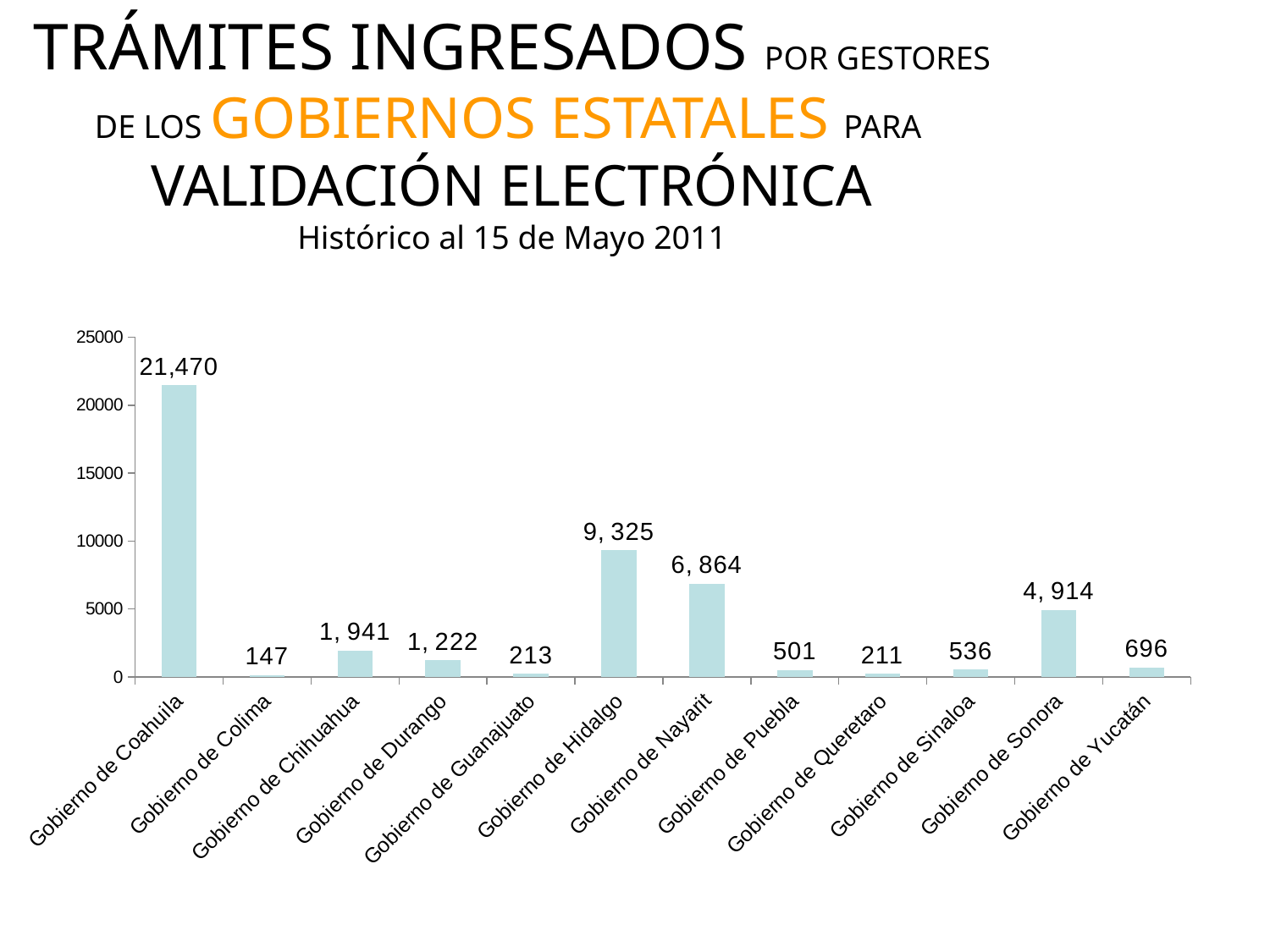
Is the value for Gobierno de Coahuila greater or less than 20000? greater What is the value for Gobierno de Coahuila? 21,470 Up to what date does the slide say the data is historical? 15 de Mayo 2011 Which category has the lowest value? Gobierno de Colima What is the value for Gobierno de Hidalgo? 9, 325 How many categories are shown on the x axis? 12 Which category has the highest value? Gobierno de Coahuila What is the difference between the values for Gobierno de Coahuila and Gobierno de Hidalgo? 12,145 What kind of chart is shown on the slide? bar chart What is the value for Gobierno de Sonora? 4, 914 What is the difference between the values for Gobierno de Hidalgo and Gobierno de Nayarit? 2,461 Which is larger, the value for Gobierno de Sonora or Gobierno de Nayarit? Gobierno de Nayarit